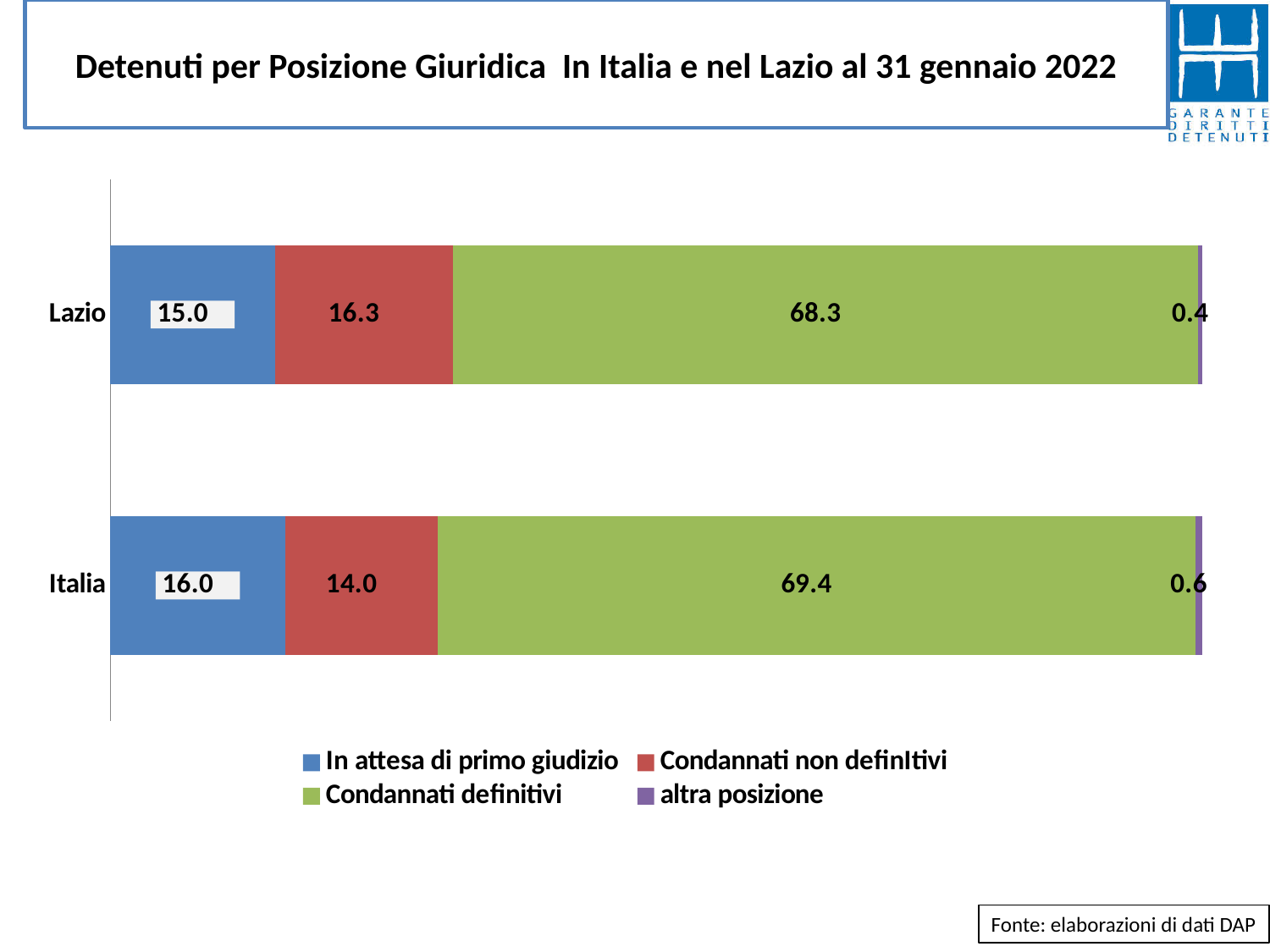
What is the value for "Condannati definitivi" for Lazio? 68.3 What is the difference between the "Condannati non definItivi" values for Lazio and Italia? 2.3 Which is larger, the "Condannati definitivi" value for Lazio or for Italia? Italia Which series has the highest value for Italia? Condannati definitivi Which series has the lowest value for Lazio? altra posizione What is the value for "altra posizione" for Italia? 0.6 What is the value for "In attesa di primo giudizio" for Italia? 16.0 How many series does the legend list? 4 What kind of chart is shown on the slide? Stacked bar chart What is the total of the stacked bar for Lazio? 100.0 What is the value for "Condannati non definItivi" for Lazio? 16.3 How many categories are shown on the y axis? 2